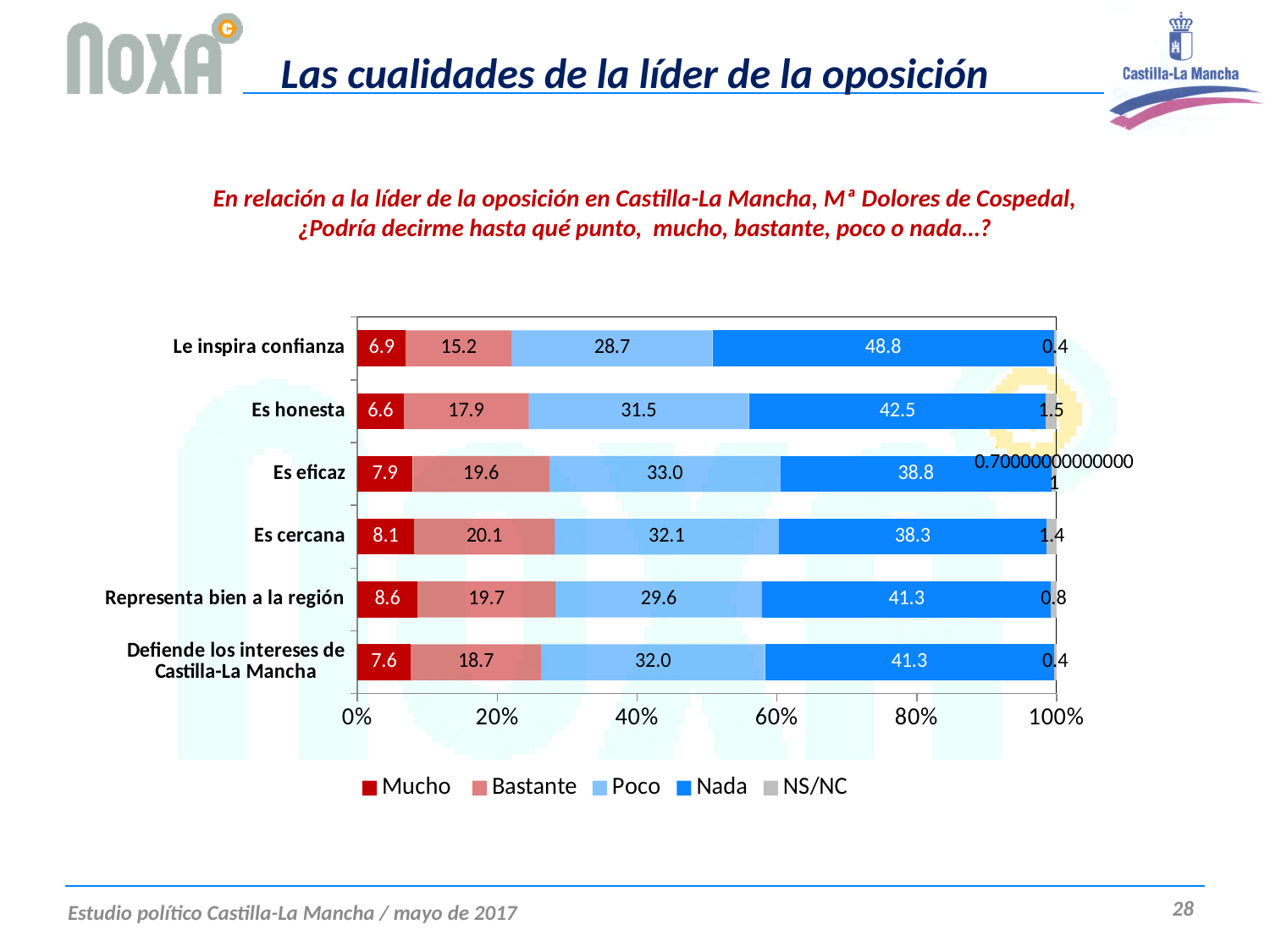
Which has the larger "Bastante" value, "Es cercana" or "Es eficaz"? Es cercana What is the difference between the "Nada" values for "Le inspira confianza" and "Es honesta"? 6.3 Which category has the highest value for "Nada"? Le inspira confianza What is the value for "Nada" in the "Le inspira confianza" bar? 48.8 How many categories are shown on the chart? 6 Which category has the lowest value for "Mucho"? Es honesta What is the value for "Poco" in the "Es eficaz" bar? 33.0 What is the value for "Mucho" in the "Representa bien a la región" bar? 8.6 How many series does the legend list? 5 What kind of chart is shown on the slide? Stacked bar chart Which category has the highest value for "Mucho"? Representa bien a la región What are the legend entries of the chart? Mucho, Bastante, Poco, Nada, NS/NC